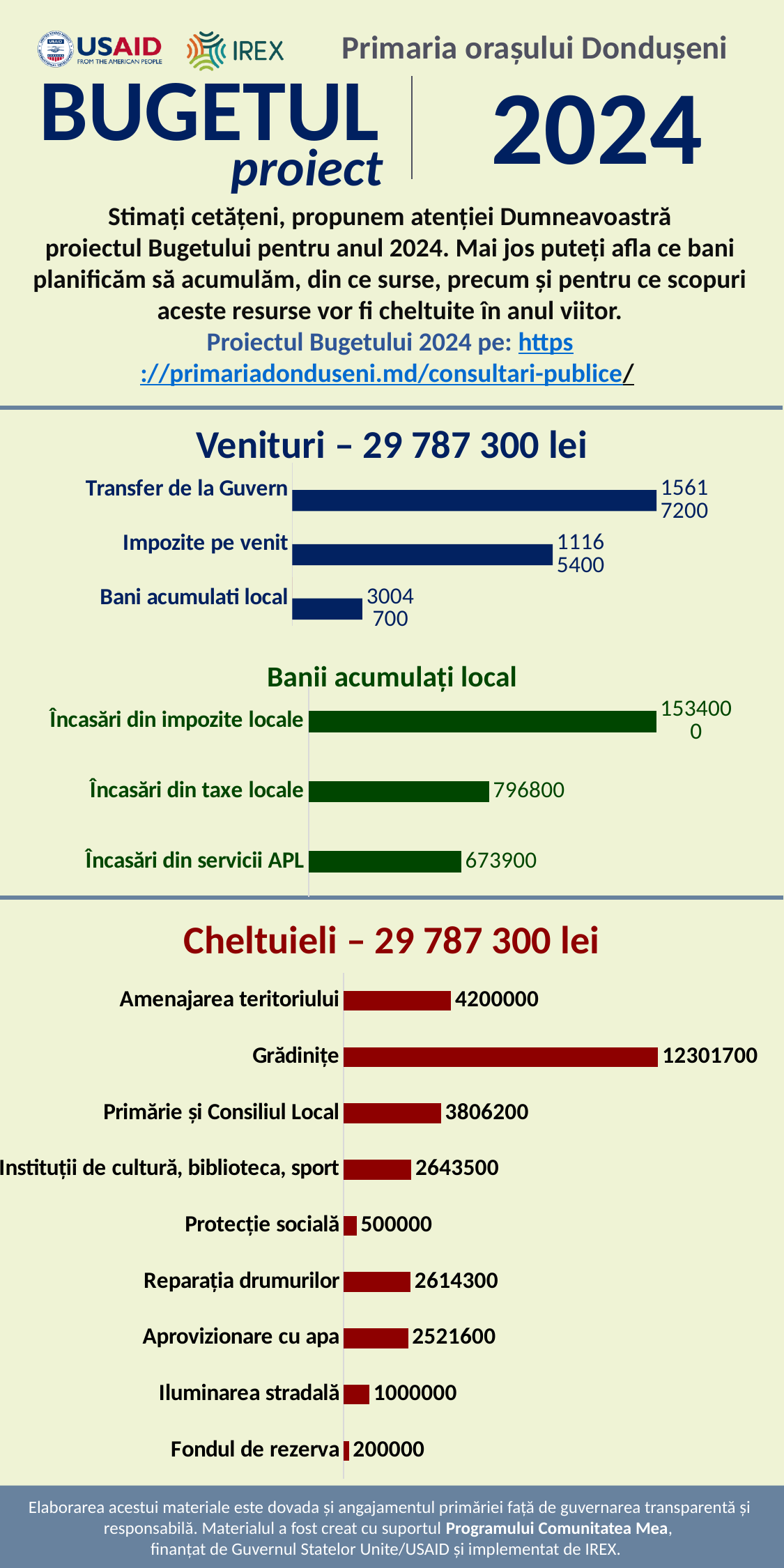
In the 'Venituri – 29 787 300 lei' chart, which category has the highest value? Transfer de la Guvern In the 'Banii acumulați local' chart, which is larger: Încasări din taxe locale or Încasări din servicii APL? Încasări din taxe locale What kind of chart is the 'Venituri – 29 787 300 lei' chart? bar chart In the 'Cheltuieli – 29 787 300 lei' chart, what is the difference between Amenajarea teritoriului and Primărie și Consiliul Local? 393800 How many categories are shown in the 'Cheltuieli – 29 787 300 lei' chart? 9 In the 'Cheltuieli – 29 787 300 lei' chart, what is the value for Grădinițe? 12301700 In the 'Cheltuieli – 29 787 300 lei' chart, which category has the lowest value? Fondul de rezerva In the 'Cheltuieli – 29 787 300 lei' chart, what is the value for Iluminarea stradală? 1000000 In the 'Banii acumulați local' chart, what is the value for Încasări din taxe locale? 796800 In the 'Cheltuieli – 29 787 300 lei' chart, what is the difference between Reparația drumurilor and Aprovizionare cu apa? 92700 In the 'Cheltuieli – 29 787 300 lei' chart, which category has the highest value? Grădinițe How many categories are shown in the 'Banii acumulați local' chart? 3